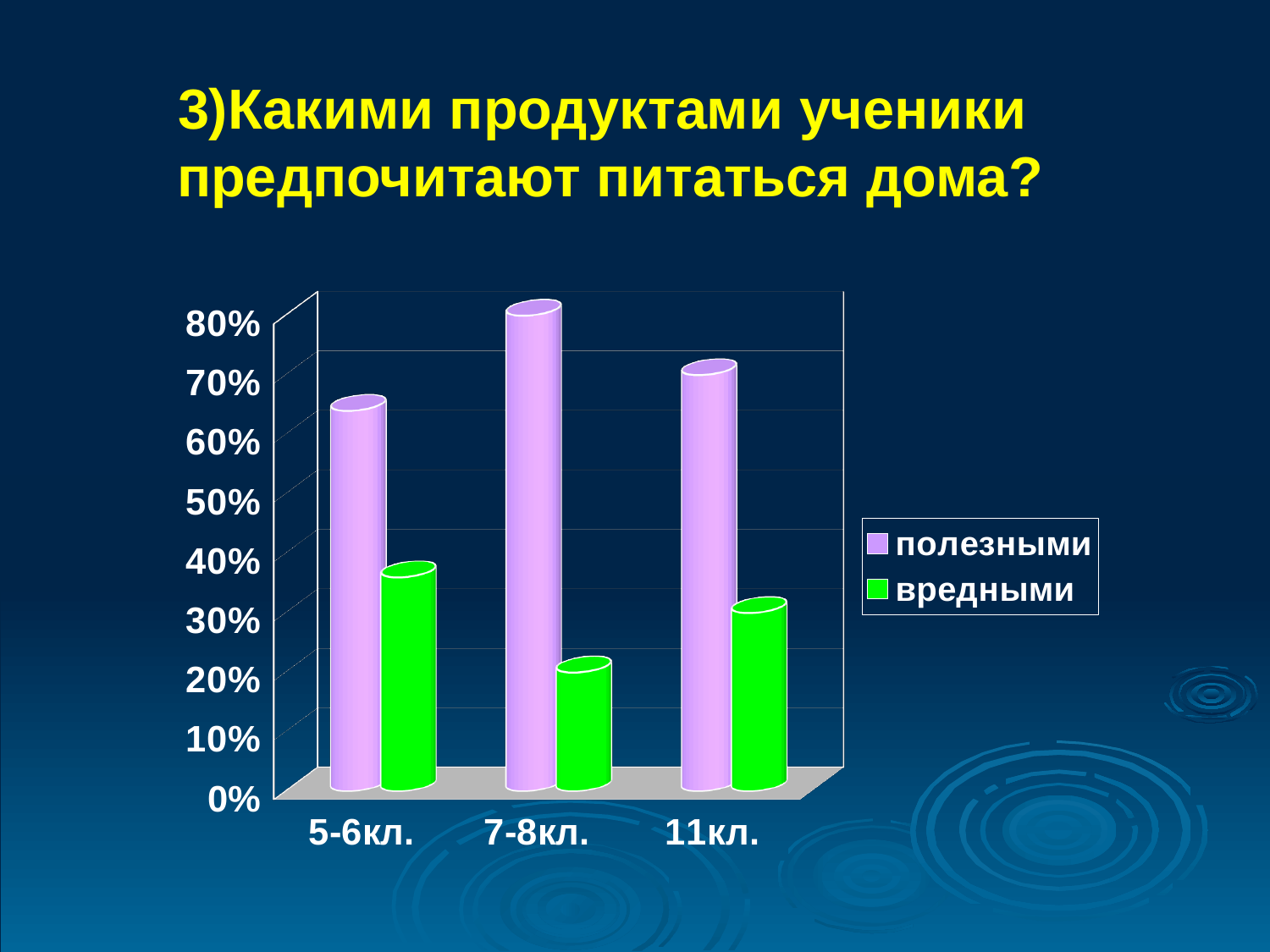
Which class group has the highest value for полезными? 7-8кл. How many class groups are shown on the x axis? 3 What are the two entries in the chart legend? полезными, вредными Which class group has the lowest value for вредными? 7-8кл. Is the value for вредными in 11кл. greater or less than 50%? less For 5-6кл., which is larger: полезными or вредными? полезными Is the value for полезными in 7-8кл. greater or less than 70%? greater Is the value for вредными in 7-8кл. greater or less than 30%? less What kind of chart is shown on the slide? bar chart Which class group has the highest value for вредными? 5-6кл. How many series does the legend list? 2